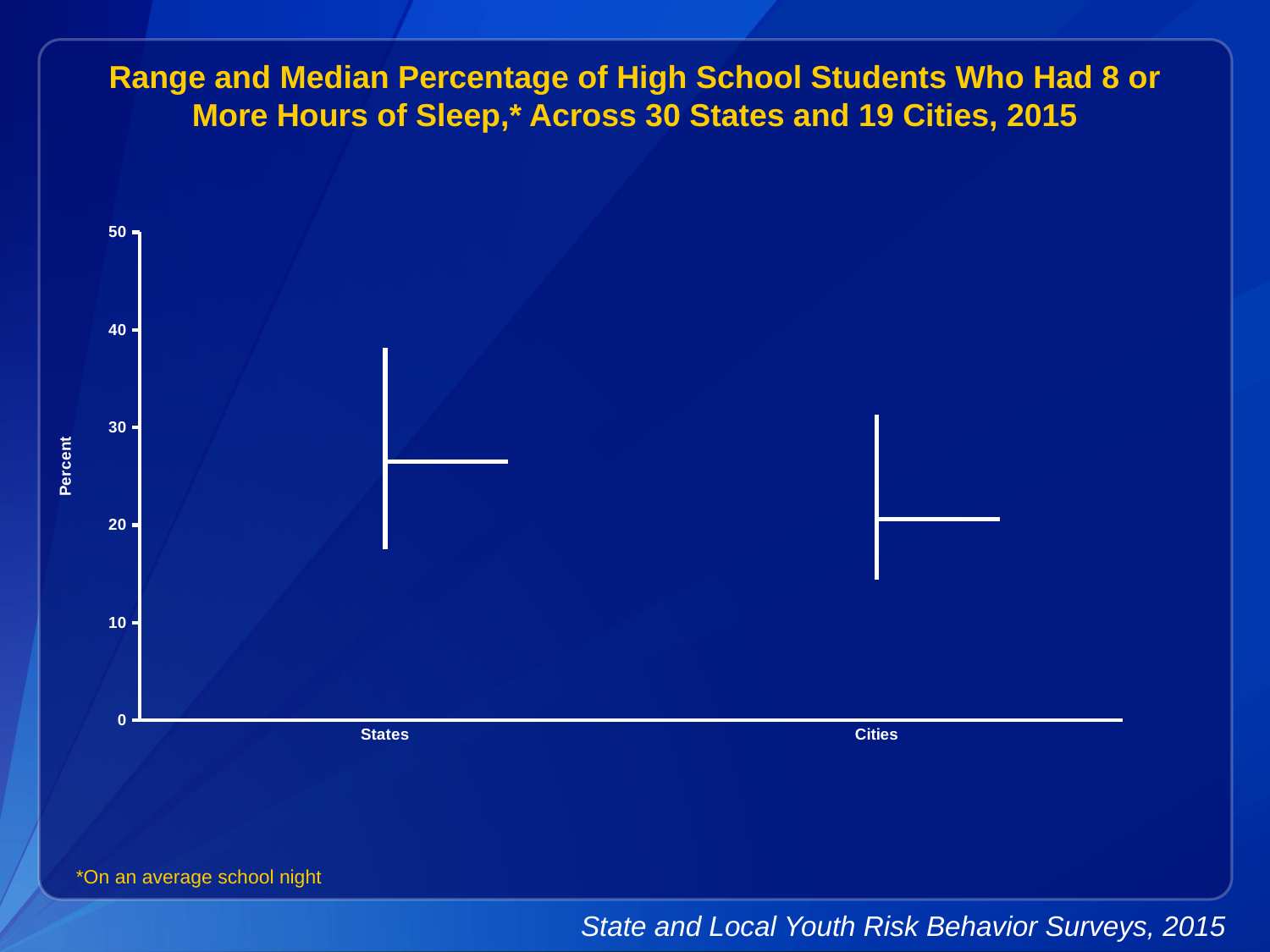
Is the median value for States greater or less than 30? less Which category has the lower bottom of its range, States or Cities? Cities How many categories are shown on the x axis of the chart? 2 What is the label on the y axis of the chart? Percent Is the top of the range for States greater or less than 40? less Is the median value for States greater or less than 20? greater Which category has the higher top of its range, States or Cities? States What is the highest value shown on the y axis of the chart? 50 Which category has the higher median percentage, States or Cities? States